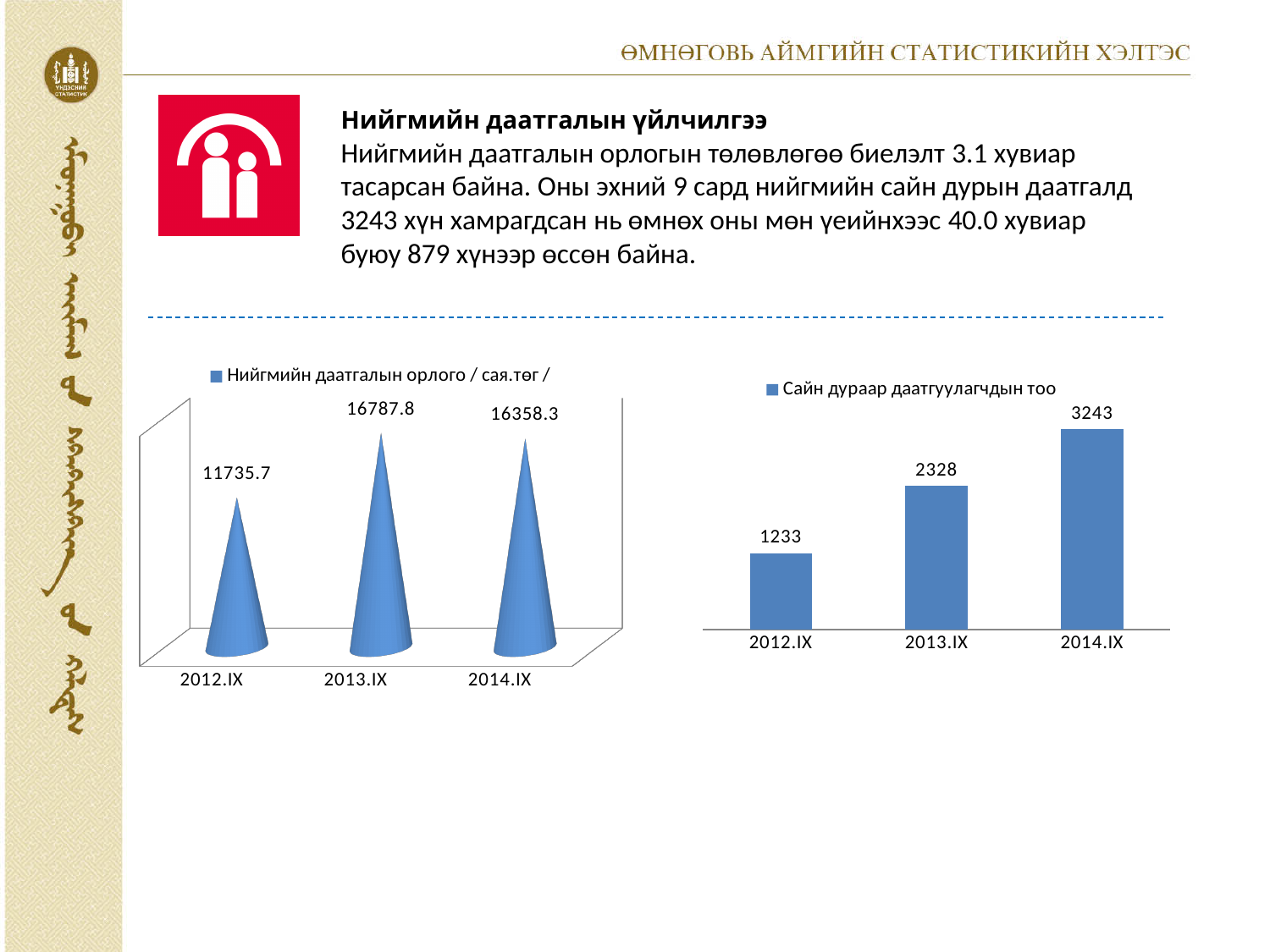
In the right chart (Сайн дураар даатгуулагчдын тоо), what is the value for 2014.IX? 3243 In the right chart (Сайн дураар даатгуулагчдын тоо), do the values rise or fall from 2012.IX to 2014.IX? rise In the left chart (Нийгмийн даатгалын орлого / сая.төг /), how many periods are shown on the x axis? 3 What kind of chart is the right chart (Сайн дураар даатгуулагчдын тоо)? bar chart In the left chart (Нийгмийн даатгалын орлого / сая.төг /), which period has the lowest value? 2012.IX In the left chart (Нийгмийн даатгалын орлого / сая.төг /), what is the value for 2012.IX? 11735.7 In the right chart (Сайн дураар даатгуулагчдын тоо), what is the value for 2012.IX? 1233 In the left chart (Нийгмийн даатгалын орлого / сая.төг /), what is the difference between the values for 2013.IX and 2014.IX? 429.5 In the right chart (Сайн дураар даатгуулагчдын тоо), which is larger, the value for 2013.IX or 2012.IX? 2013.IX In the left chart (Нийгмийн даатгалын орлого / сая.төг /), which period has the highest value? 2013.IX In the right chart (Сайн дураар даатгуулагчдын тоо), what is the difference between the values for 2014.IX and 2013.IX? 915 In the left chart (Нийгмийн даатгалын орлого / сая.төг /), what is the value for 2013.IX? 16787.8